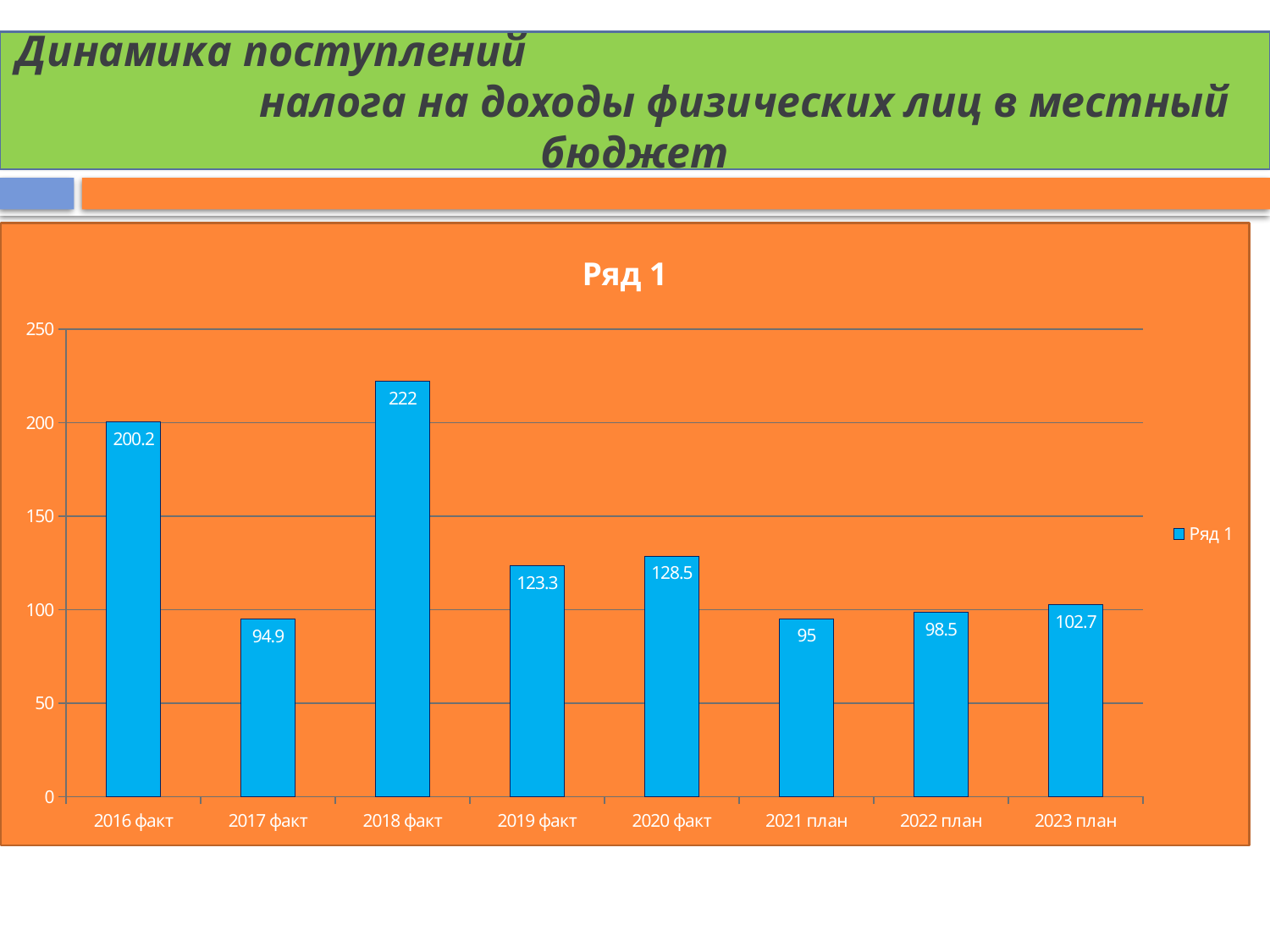
What kind of chart is shown? bar chart Which category has the lowest value? 2017 факт Is the value for 2021 план greater or less than 100? less Which category has the highest value? 2018 факт Which is larger, the value for 2019 факт or the value for 2020 факт? 2020 факт What is the value for 2023 план? 102.7 What is the difference between the values for 2018 факт and 2016 факт? 21.8 How many series does the legend list? 1 How many categories are shown on the x axis? 8 What is the value for 2016 факт? 200.2 What is the value for 2020 факт? 128.5 What is the difference between the values for 2022 план and 2021 план? 3.5